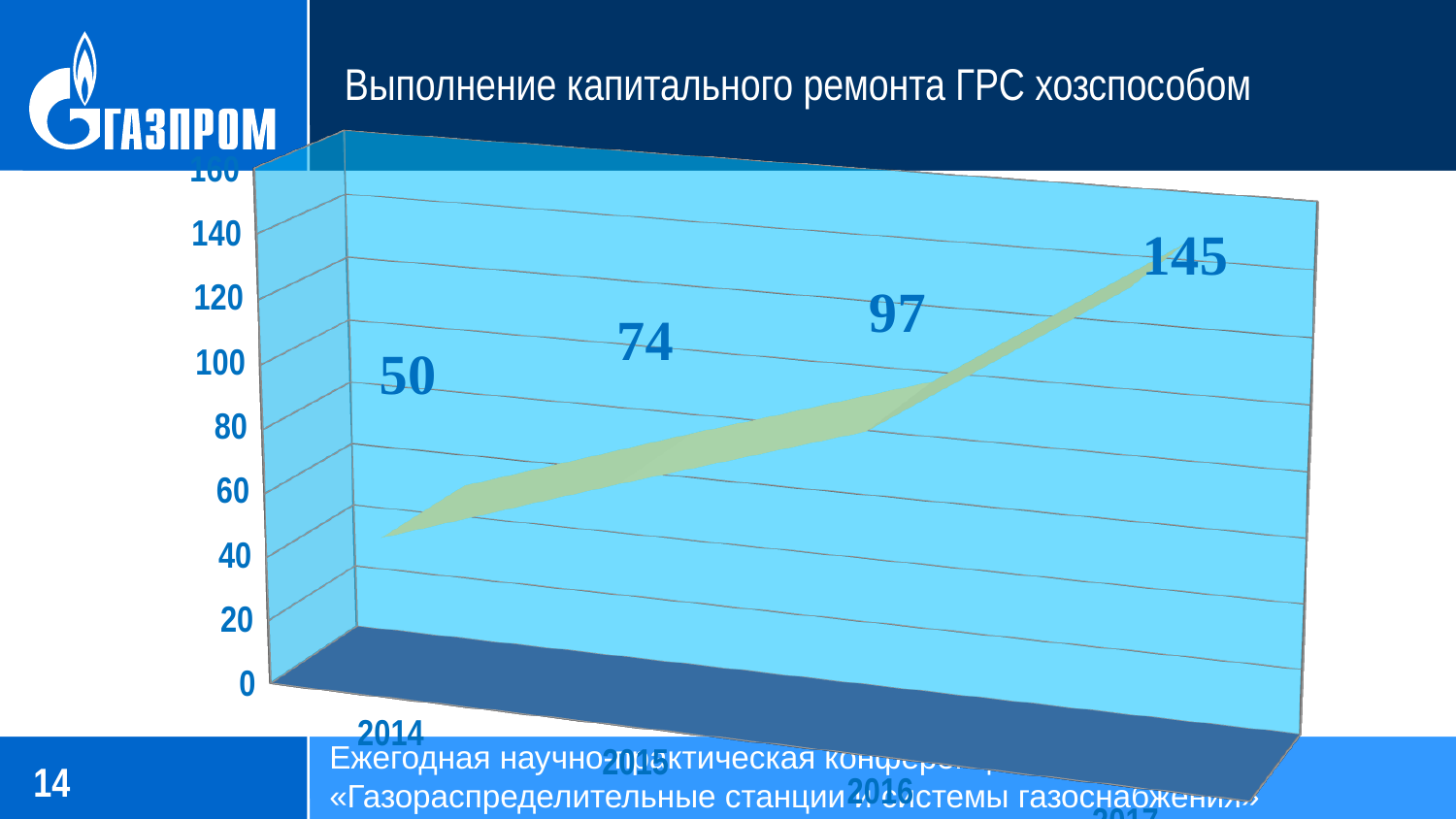
Do the values rise or fall from 2014 onward along the x axis? Rise Which year has the lowest value? 2014 What kind of chart is shown on the slide? Line chart What is the difference between the values for 2015 and 2014? 24 Which is larger, the value for 2015 or the value for 2016? 2016 What is the highest value plotted on the chart? 145 What is the value for 2016? 97 What is the value for 2014? 50 What is the difference between the last point (145) and the value for 2016? 48 What is the value for 2015? 74 What is the difference between the values for 2016 and 2015? 23 How many data points are plotted on the chart? 4